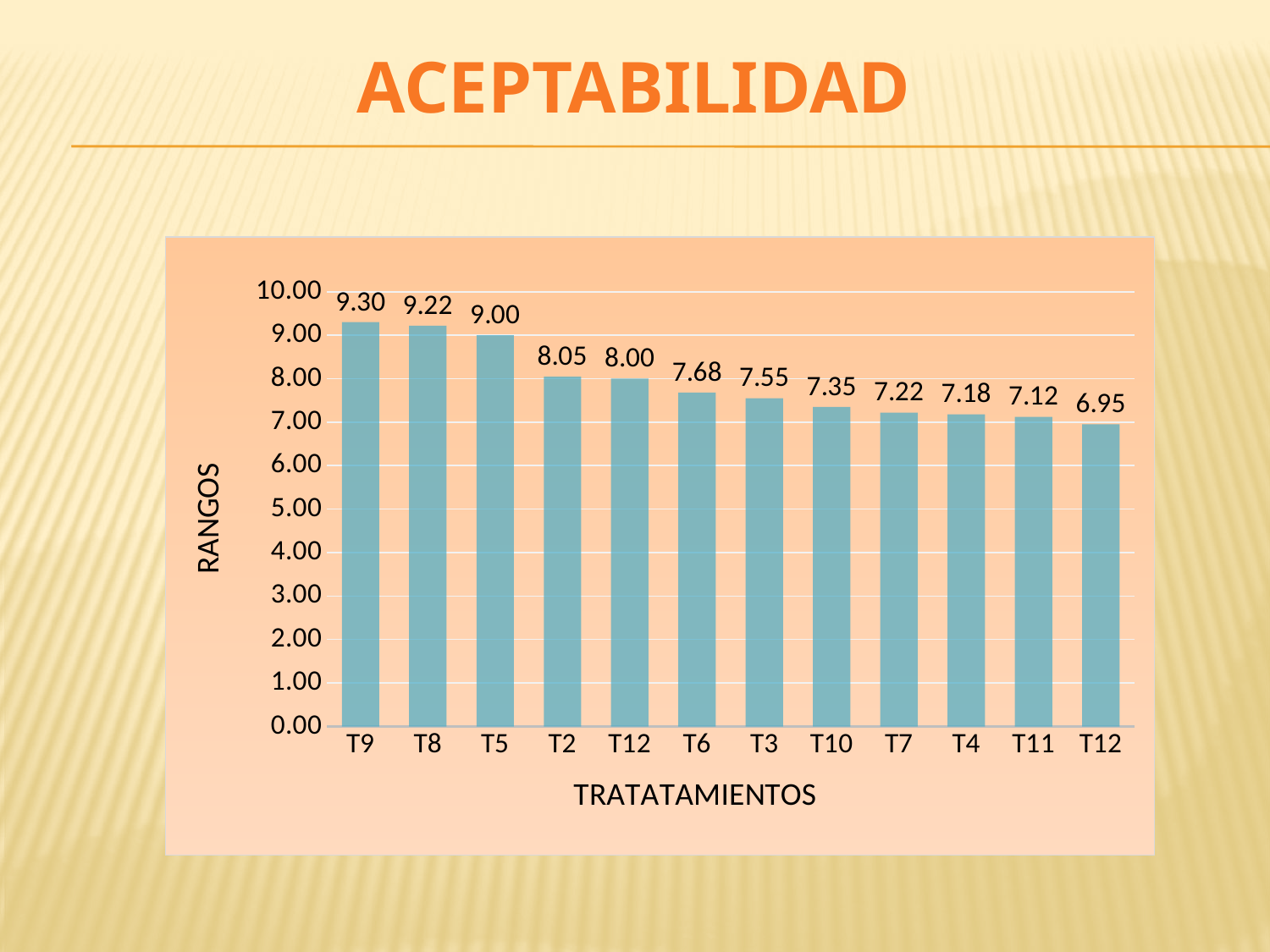
What is the value for T10? 7.35 Which treatment has the highest value? T9 What is the value for T2? 8.05 What is the lowest value shown in the chart? 6.95 What is the value for T11? 7.12 What is the difference between the values for T9 and T11? 2.18 How many bars are shown in the chart? 12 What kind of chart is shown on the slide? Bar chart Do the values rise or fall from left to right along the x axis? Fall What is the value for T9? 9.30 What is the difference between the values for T5 and T2? 0.95 Which is larger, the value for T6 or the value for T3? T6